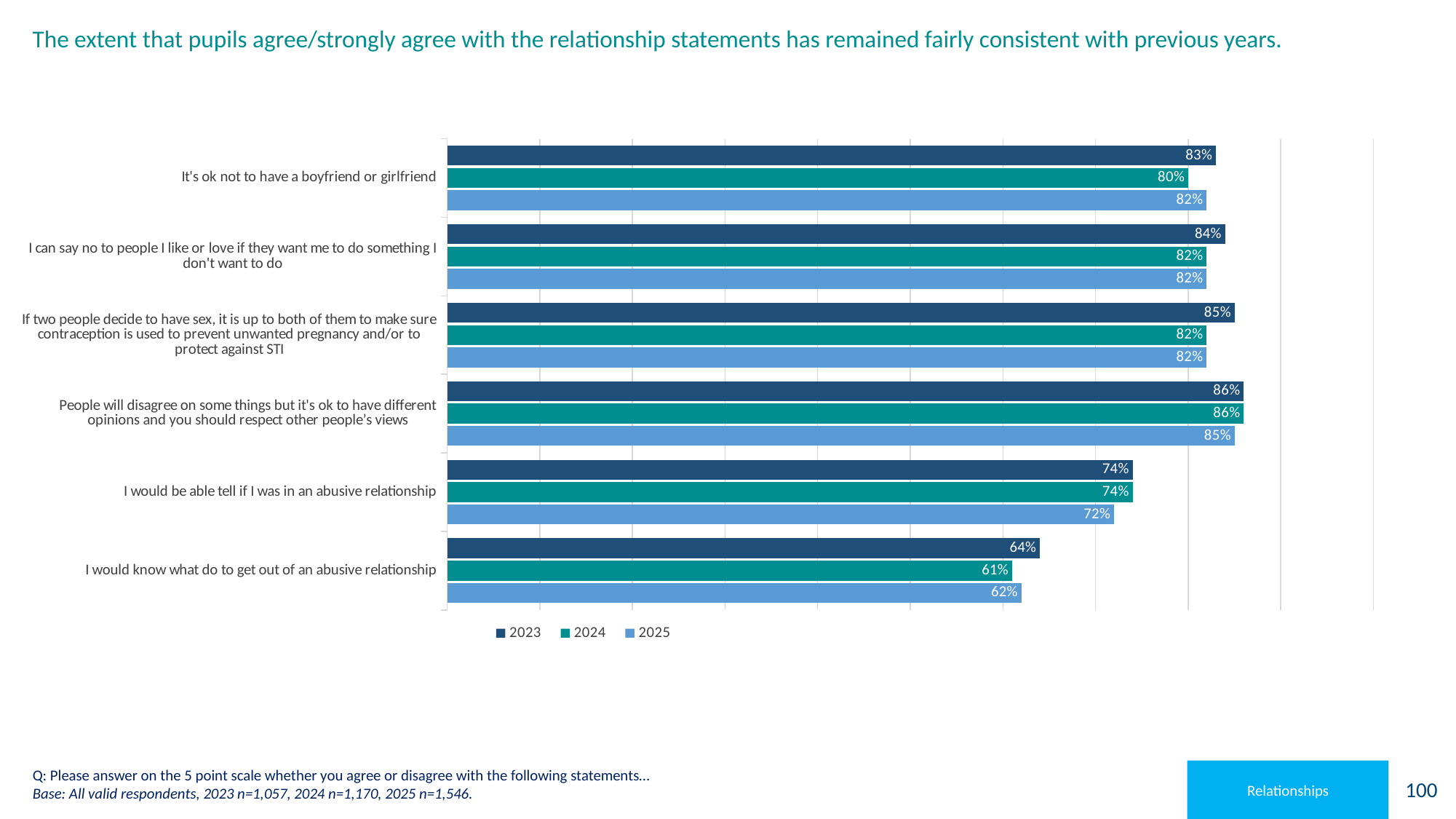
Which statement has the lowest 2025 value? I would know what do to get out of an abusive relationship What is the difference between the 2023 and 2025 values for "I would be able tell if I was in an abusive relationship"? 2 percentage points How many statements are shown on the chart? 6 What is the difference between the 2023 and 2024 values for "I would know what do to get out of an abusive relationship"? 3 percentage points What is the 2024 value for "I would be able tell if I was in an abusive relationship"? 74% What is the 2023 value for "It's ok not to have a boyfriend or girlfriend"? 83% Which years are listed in the chart legend? 2023, 2024, 2025 How many series does the legend list? 3 Which is larger for "It's ok not to have a boyfriend or girlfriend": the 2024 value or the 2025 value? 2025 What kind of chart is shown on the slide? Bar chart What is the 2025 value for "I would know what do to get out of an abusive relationship"? 62% Which statement has the highest 2023 value? People will disagree on some things but it's ok to have different opinions and you should respect other people's views